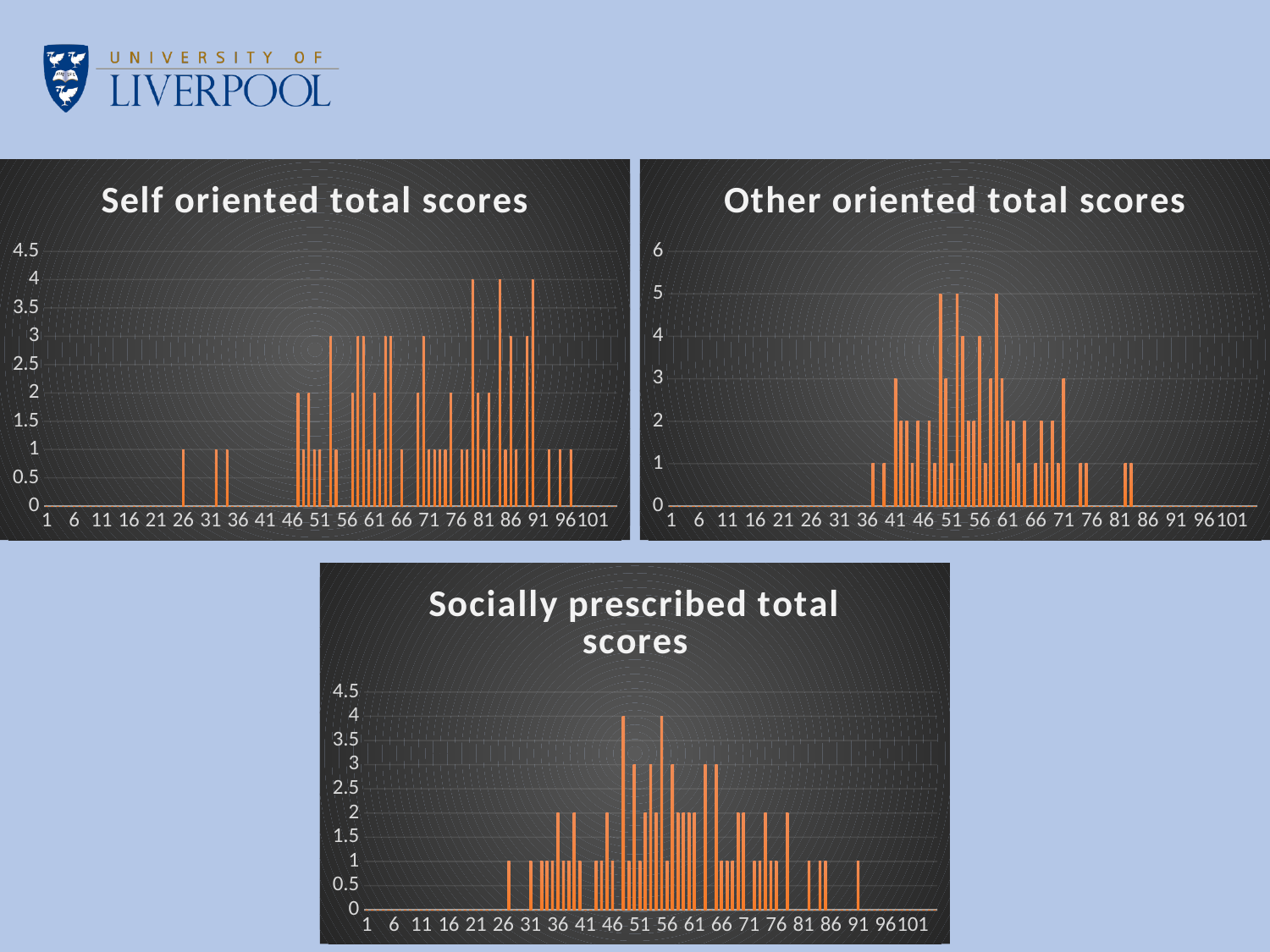
In the 'Self oriented total scores' chart, is the value for category 26 greater or less than 2? less How many charts are shown on the slide? 3 In the 'Socially prescribed total scores' chart, what is the highest value reached by any bar? 4 What is the title of the chart at the bottom of the slide? Socially prescribed total scores What is the last category label on the horizontal axis of the 'Self oriented total scores' chart? 101 In the 'Self oriented total scores' chart, what is the highest value reached by any bar? 4 What is the maximum value shown on the vertical axis of the 'Other oriented total scores' chart? 6 In the 'Other oriented total scores' chart, what is the highest value reached by any bar? 5 Which chart has the taller highest bar, 'Self oriented total scores' or 'Other oriented total scores'? Other oriented total scores What kind of chart is the 'Self oriented total scores' chart? bar chart In the 'Socially prescribed total scores' chart, is the value for category 26 greater or less than 2? less